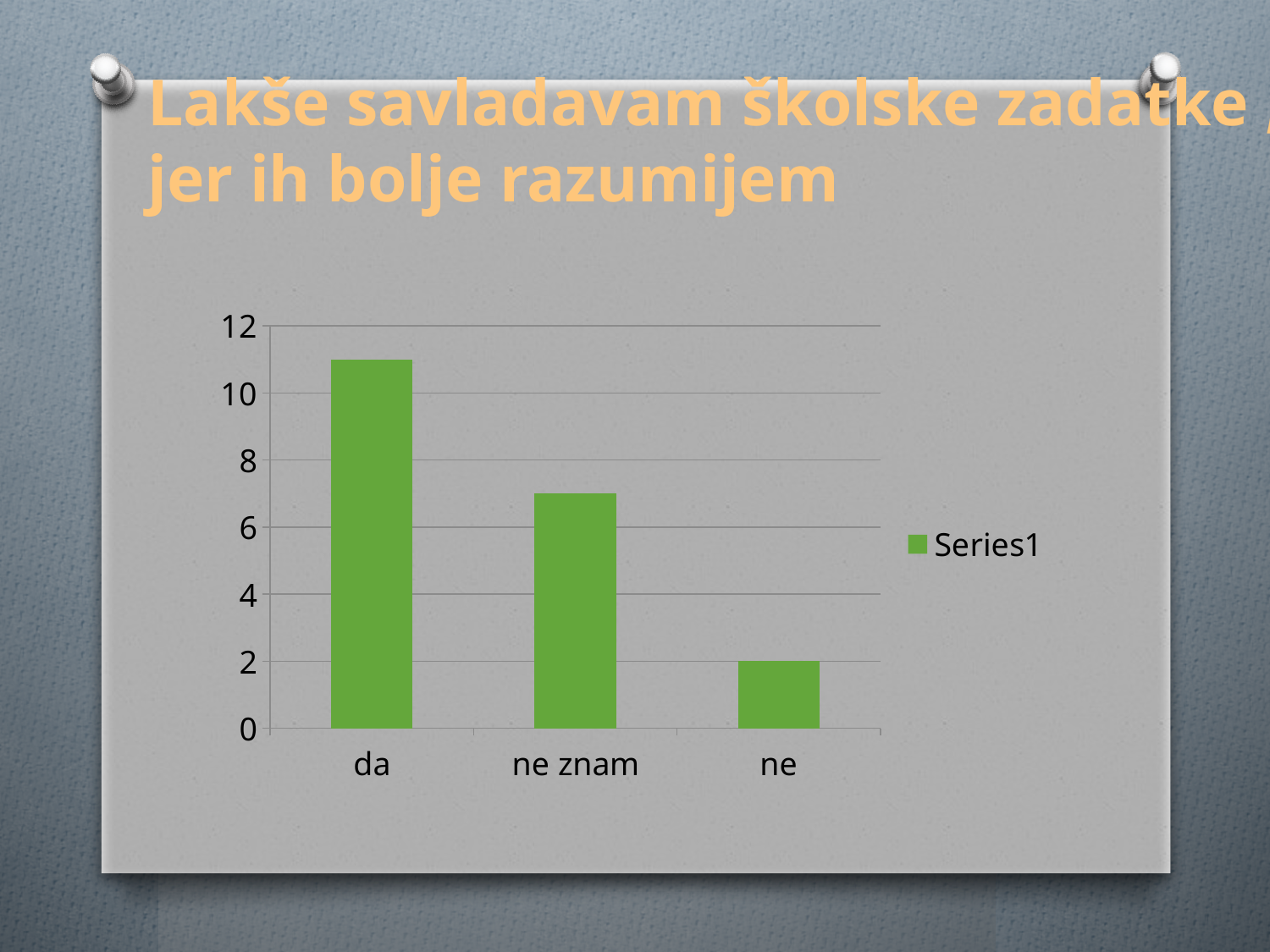
Is the value for "da" greater or less than 10? greater Which category has the lowest bar? ne Is the value for "ne znam" greater or less than 6? greater Which is larger, the value for "da" or the value for "ne znam"? da What kind of chart is shown on the slide? bar chart Do the bar values rise or fall from left to right along the x axis? fall What is the name of the series shown in the legend? Series1 Which category has the highest bar? da What is the value for "ne"? 2 How many categories are shown on the x axis of the chart? 3 Is the value for "ne znam" greater or less than 8? less How many series does the chart's legend list? 1